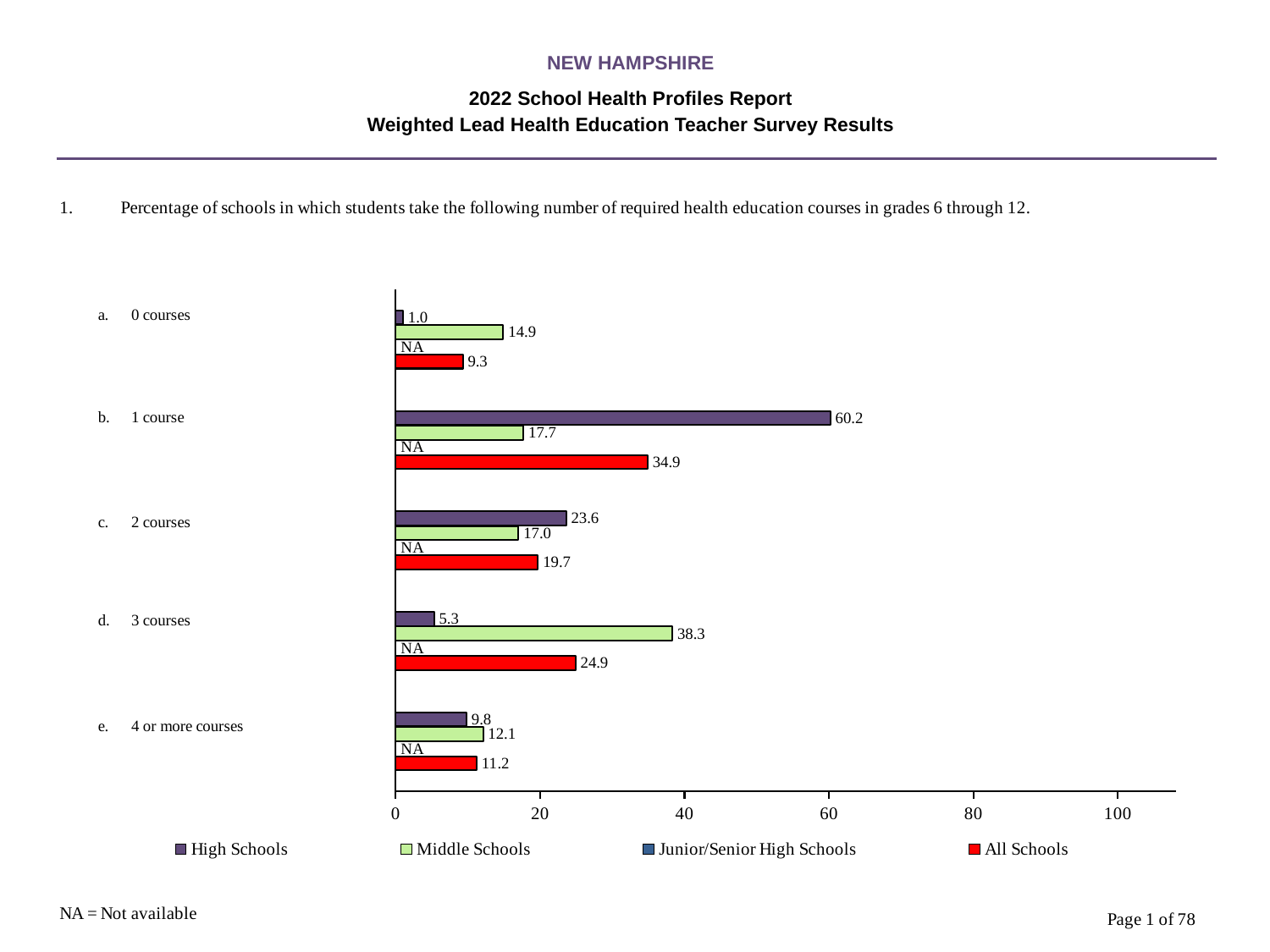
Which category has the highest value for High Schools? 1 course What is the All Schools value for '4 or more courses'? 11.2 What is the value for Middle Schools in the '3 courses' category? 38.3 What kind of chart is shown on the slide? Bar chart Which category has the lowest value for Middle Schools? 4 or more courses What is the difference between the High Schools and Middle Schools values for '1 course'? 42.5 What is the All Schools value for '0 courses'? 9.3 How many categories (course counts) are shown on the chart? 5 How many series does the legend list? 4 What percentage of High Schools require 1 course? 60.2 What value is shown for Junior/Senior High Schools in every category? NA Which is larger for '2 courses': High Schools or Middle Schools? High Schools